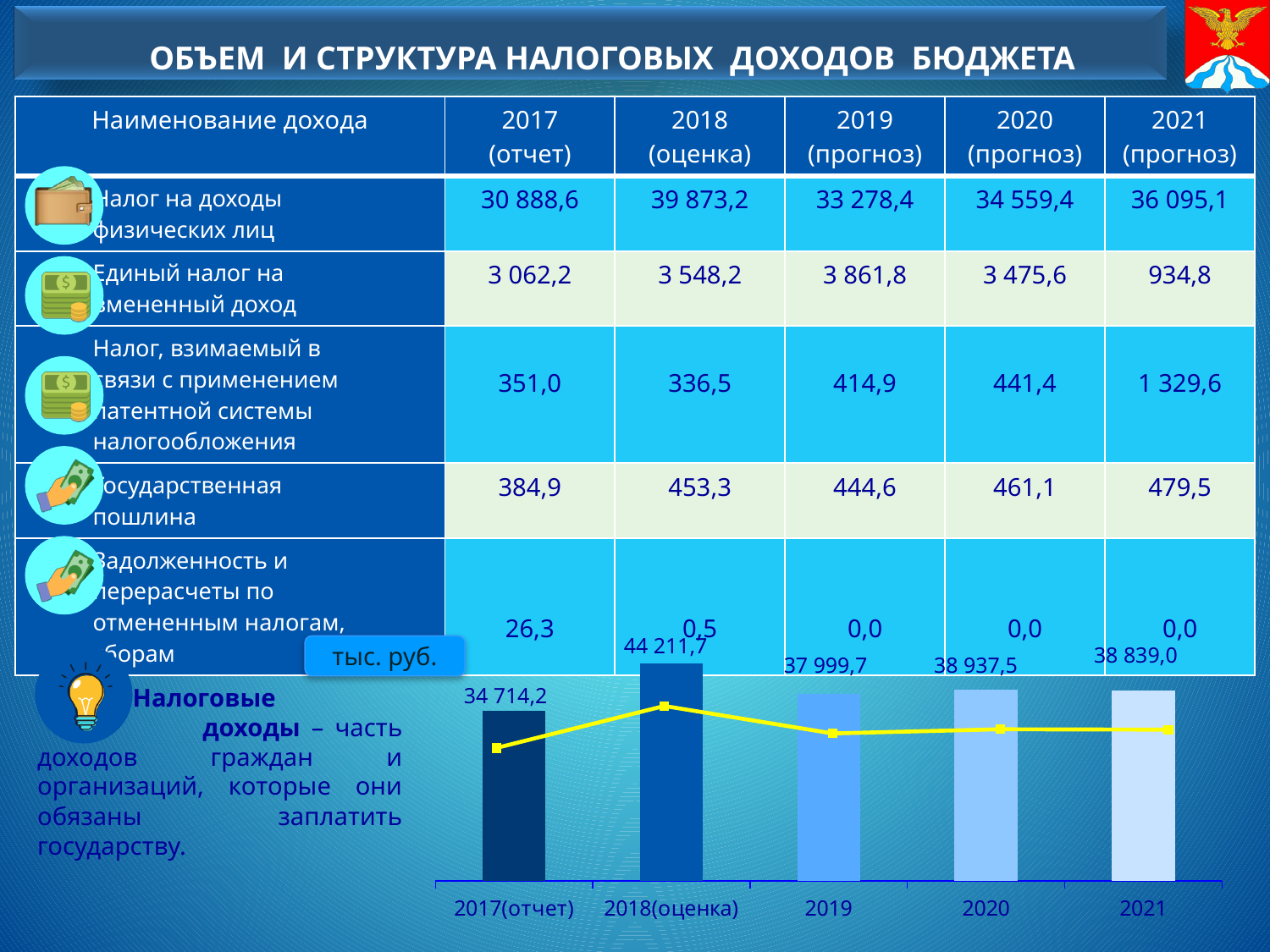
What is the value shown for 2017(отчет) in the bar chart? 34 714,2 What unit label is shown next to the chart? тыс. руб. What kind of chart is shown at the bottom of the slide? Bar chart with a line overlay Which year has the lowest value in the bar chart? 2017(отчет) How many years (categories) are shown on the x axis of the bar chart? 5 In the bar chart, which is larger: the value for 2018(оценка) or the value for 2019? 2018(оценка) What is the value shown for 2021 in the bar chart? 38 839,0 What is the value shown for 2018(оценка) in the bar chart? 44 211,7 In the bar chart, what is the difference between the 2018(оценка) value and the 2017(отчет) value? 9 497,5 In the bar chart, what is the difference between the 2020 value and the 2019 value? 937,8 Which year has the highest value in the bar chart? 2018(оценка) What is the value shown for 2019 in the bar chart? 37 999,7